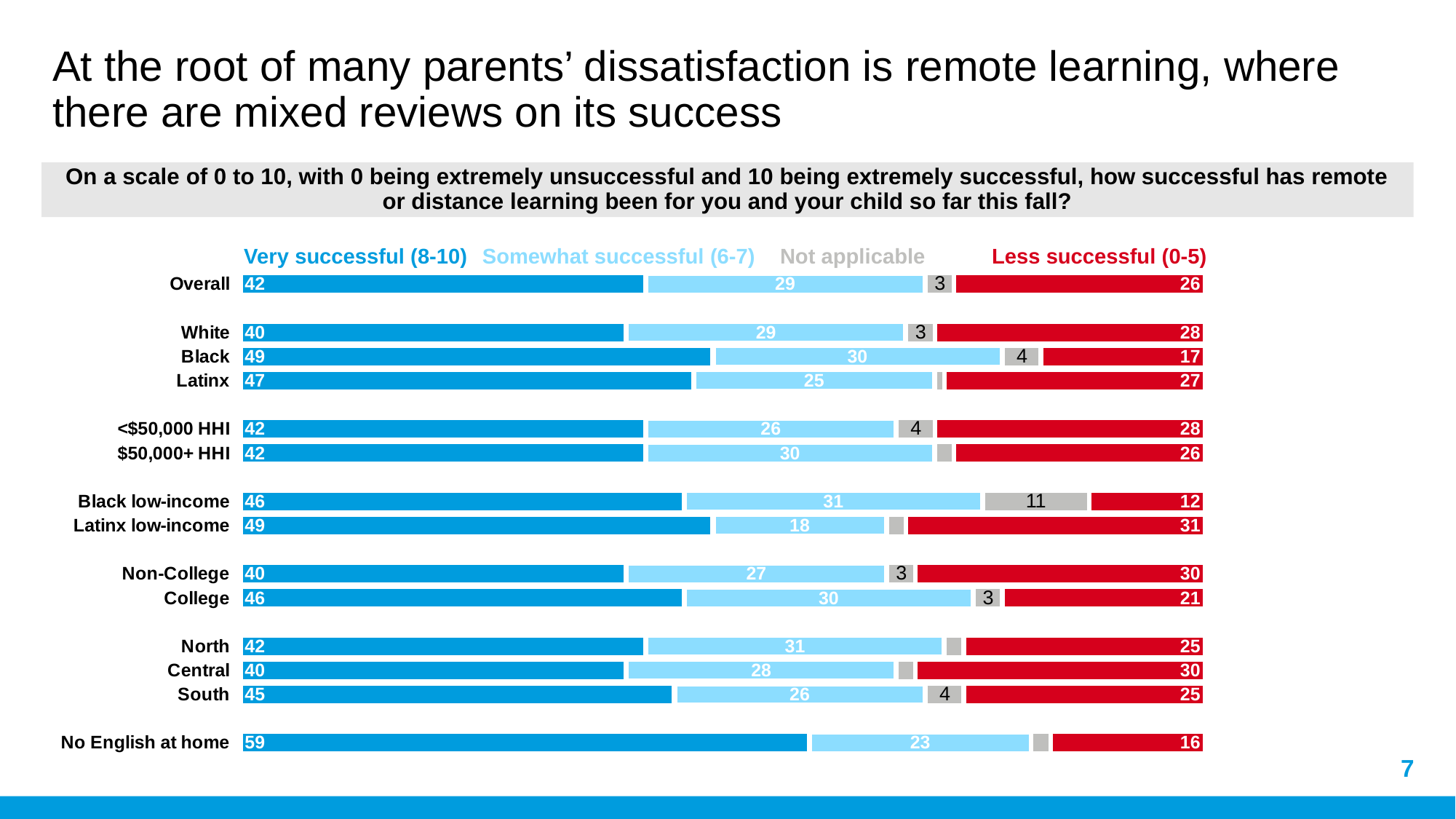
Which group has the lowest Less successful (0-5) value? Black low-income What is the Less successful (0-5) value for Black low-income parents? 12 What is the difference between the Less successful (0-5) values for Latinx low-income and Black low-income parents? 19 What percentage of Overall respondents rated remote learning as Very successful (8-10)? 42 What type of chart is shown on the slide? Stacked bar chart What is the Not applicable value for Black low-income parents? 11 How many series does the legend list? 4 Which group has a larger Very successful (8-10) value, Black or White? Black Which group has the highest Very successful (8-10) value? No English at home Which group has the highest Less successful (0-5) value? Latinx low-income What is the Somewhat successful (6-7) value for Latinx low-income parents? 18 How many groups (bars) are shown in the chart? 14